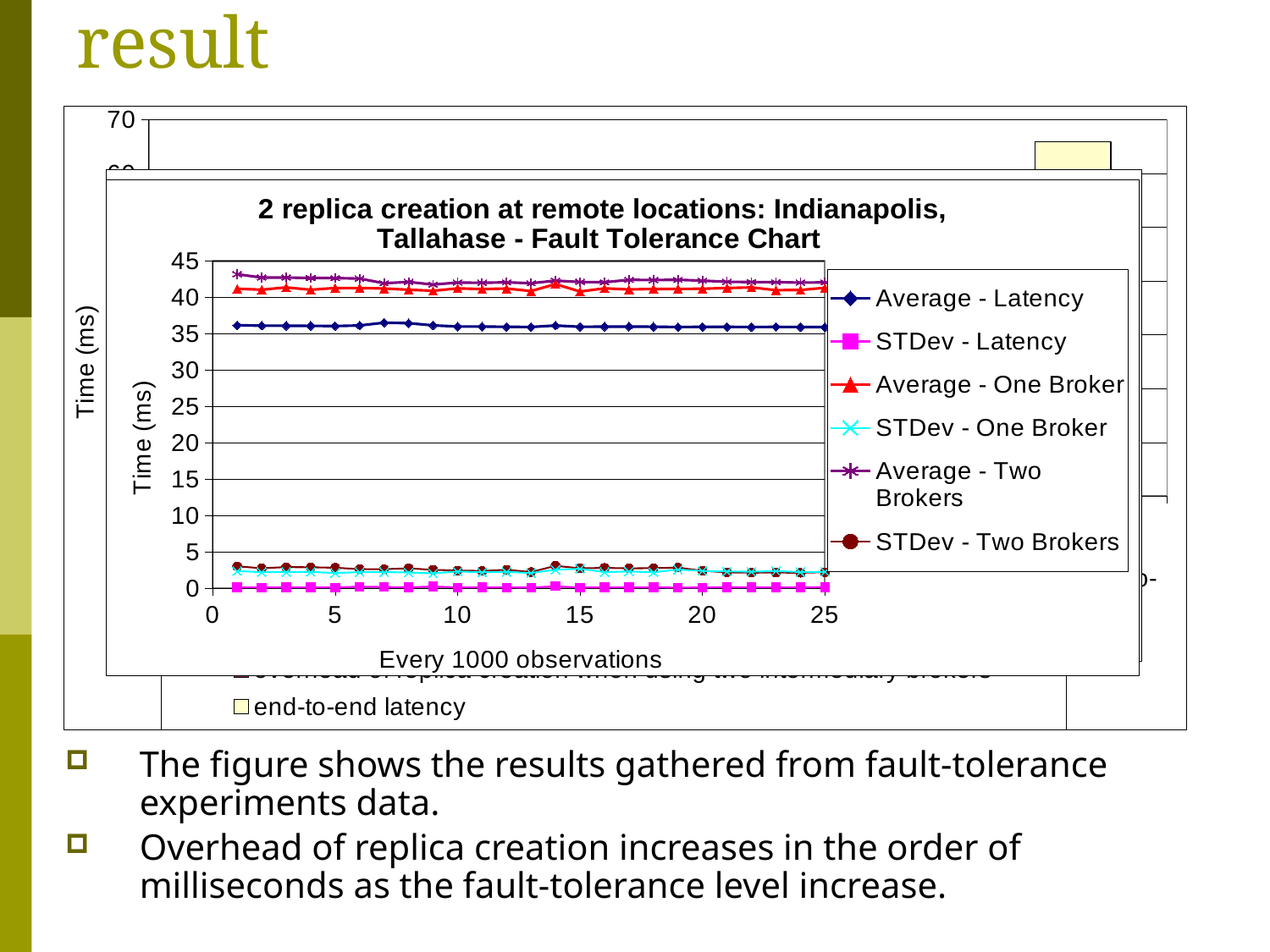
In the Fault Tolerance Chart, what is the label of the y axis? Time (ms) In the Fault Tolerance Chart, how many series does the legend list? 6 In the Fault Tolerance Chart, which series has the highest values? Average - Two Brokers In the Fault Tolerance Chart, what is the label of the x axis? Every 1000 observations In the Fault Tolerance Chart, are the values for Average - Two Brokers greater or less than 40? greater What kind of chart is the '2 replica creation at remote locations: Indianapolis, Tallahase - Fault Tolerance Chart'? line chart In the Fault Tolerance Chart, which series has higher values: Average - Two Brokers or Average - Latency? Average - Two Brokers In the Fault Tolerance Chart, which series has the lowest values? STDev - Latency In the Fault Tolerance Chart, do the Average - Latency values rise, fall, or stay roughly flat along the x axis? stay roughly flat In the Fault Tolerance Chart, are the values for Average - Latency greater or less than 40? less In the Fault Tolerance Chart, are the values for Average - One Broker greater or less than 35? greater